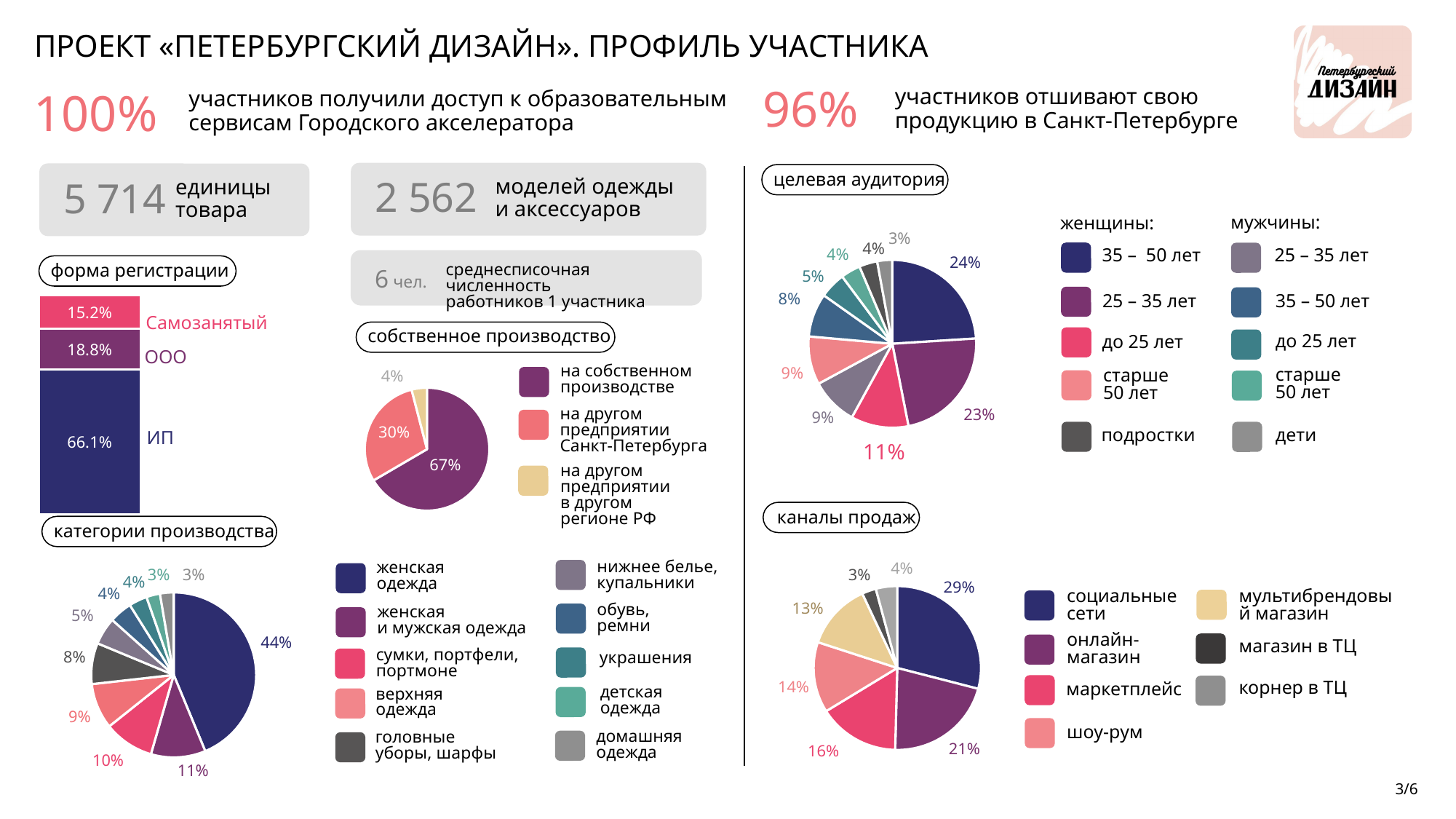
In the 'форма регистрации' chart, what is the difference between the values for ООО and Самозанятый? 3.6% In the 'категории производства' chart, what is the value for 'сумки, портфели, портмоне'? 10% In the 'каналы продаж' chart, what is the value for маркетплейс? 16% What kind of chart is the 'собственное производство' chart? pie chart In the 'каналы продаж' chart, which channel has the smallest share? магазин в ТЦ In the 'собственное производство' chart, what share is 'на другом предприятии Санкт-Петербурга'? 30% In the 'каналы продаж' chart, what is the difference between социальные сети and онлайн-магазин? 8% In the 'целевая аудитория' chart, which is larger: women 35–50 лет or women до 25 лет? women 35–50 лет In the 'категории производства' chart, which category has the largest share? женская одежда In the 'целевая аудитория' chart, what is the share for women aged 25–35 лет? 23% How many categories does the legend of the 'категории производства' chart list? 10 In the 'форма регистрации' chart, what is the value for ИП? 66.1%